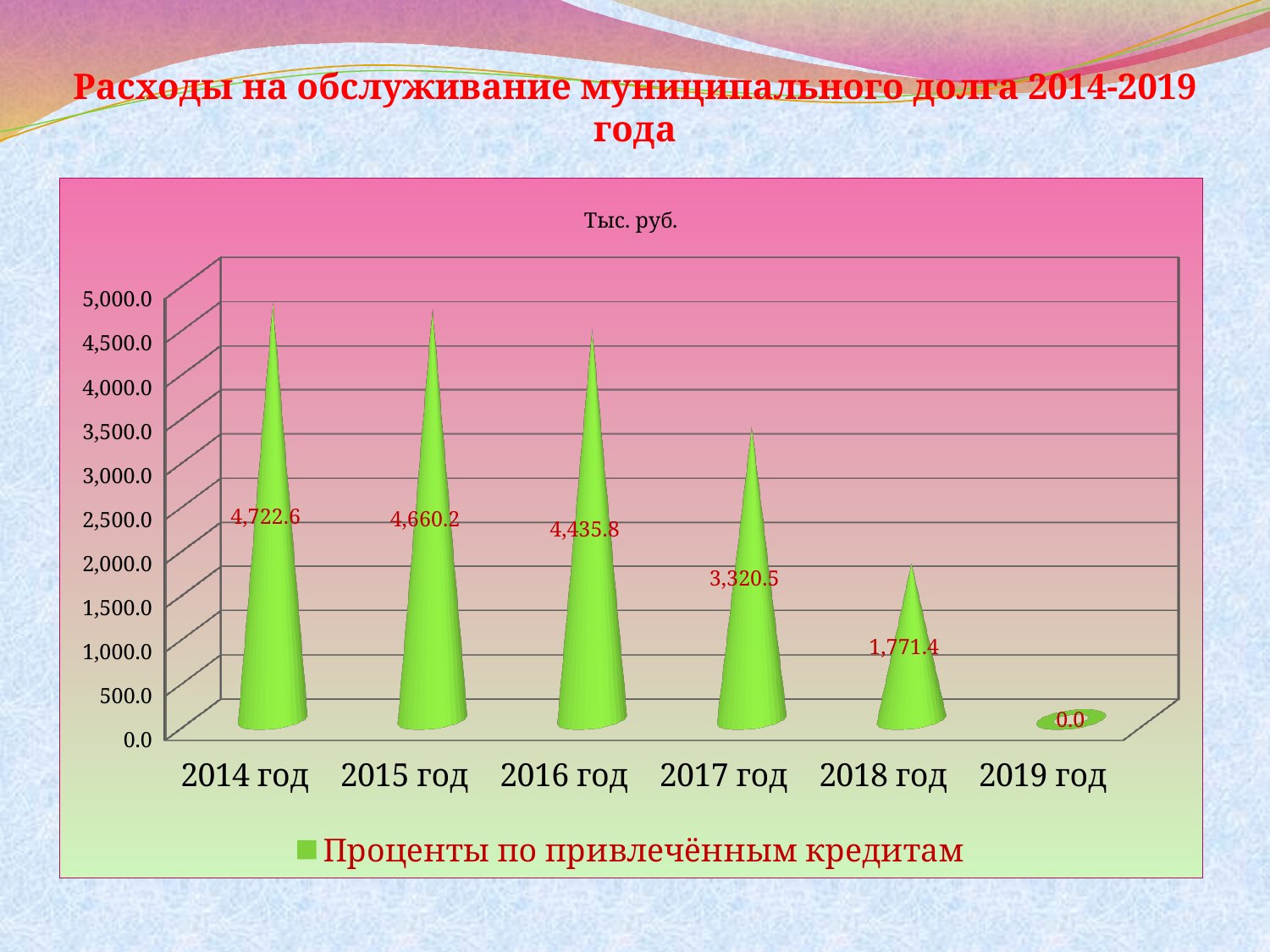
Which year has the lowest value? 2019 год Which is larger, the value for 2016 год or the value for 2017 год? 2016 год Which year has the highest value? 2014 год What is the value for 2014 год? 4,722.6 What is the difference between the values for 2014 год and 2015 год? 62.4 How many years are shown on the x axis? 6 What is the value for 2018 год? 1,771.4 What is the value for 2017 год? 3,320.5 What is the value for 2019 год? 0.0 What series does the legend list? Проценты по привлечённым кредитам Do the values rise or fall from 2014 год to 2019 год? fall What is the difference between the values for 2017 год and 2018 год? 1,549.1